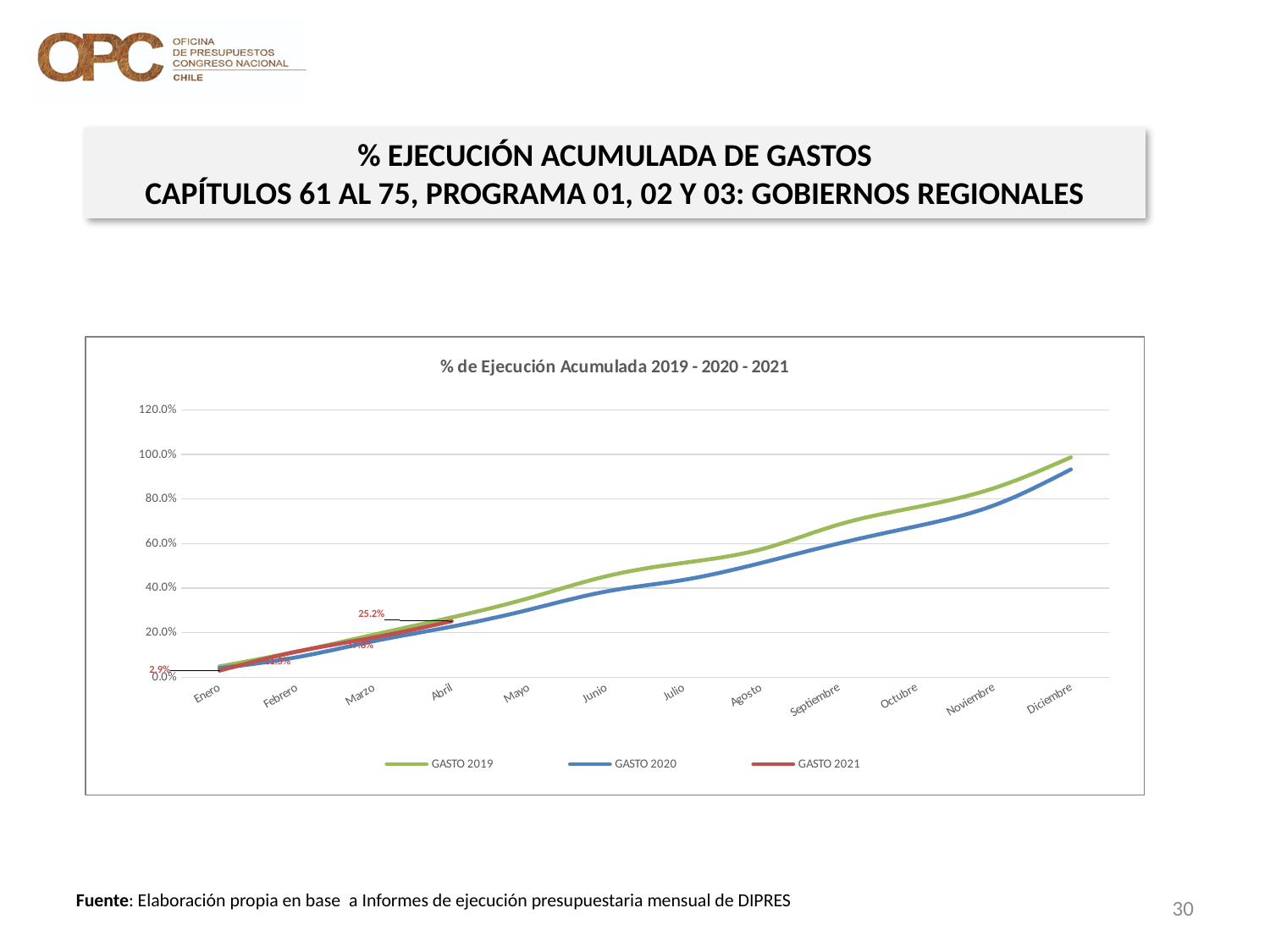
What is the difference between the GASTO 2021 values in Abril and Enero? 22.3% Do the values for GASTO 2020 rise or fall from Enero to Diciembre? rise How many months are shown along the x axis? 12 What is the value for GASTO 2021 in Enero? 2.9% What is the title of the chart? % de Ejecución Acumulada 2019 - 2020 - 2021 What kind of chart is shown on the slide? line chart Is the value for GASTO 2020 in Mayo greater or less than 40%? less How many series does the legend list? 3 In which month does GASTO 2019 reach its highest value? Diciembre What is the value for GASTO 2021 in Abril? 25.2% Is the value for GASTO 2019 in Diciembre greater or less than 80%? greater In Diciembre, which series has the higher value, GASTO 2019 or GASTO 2020? GASTO 2019